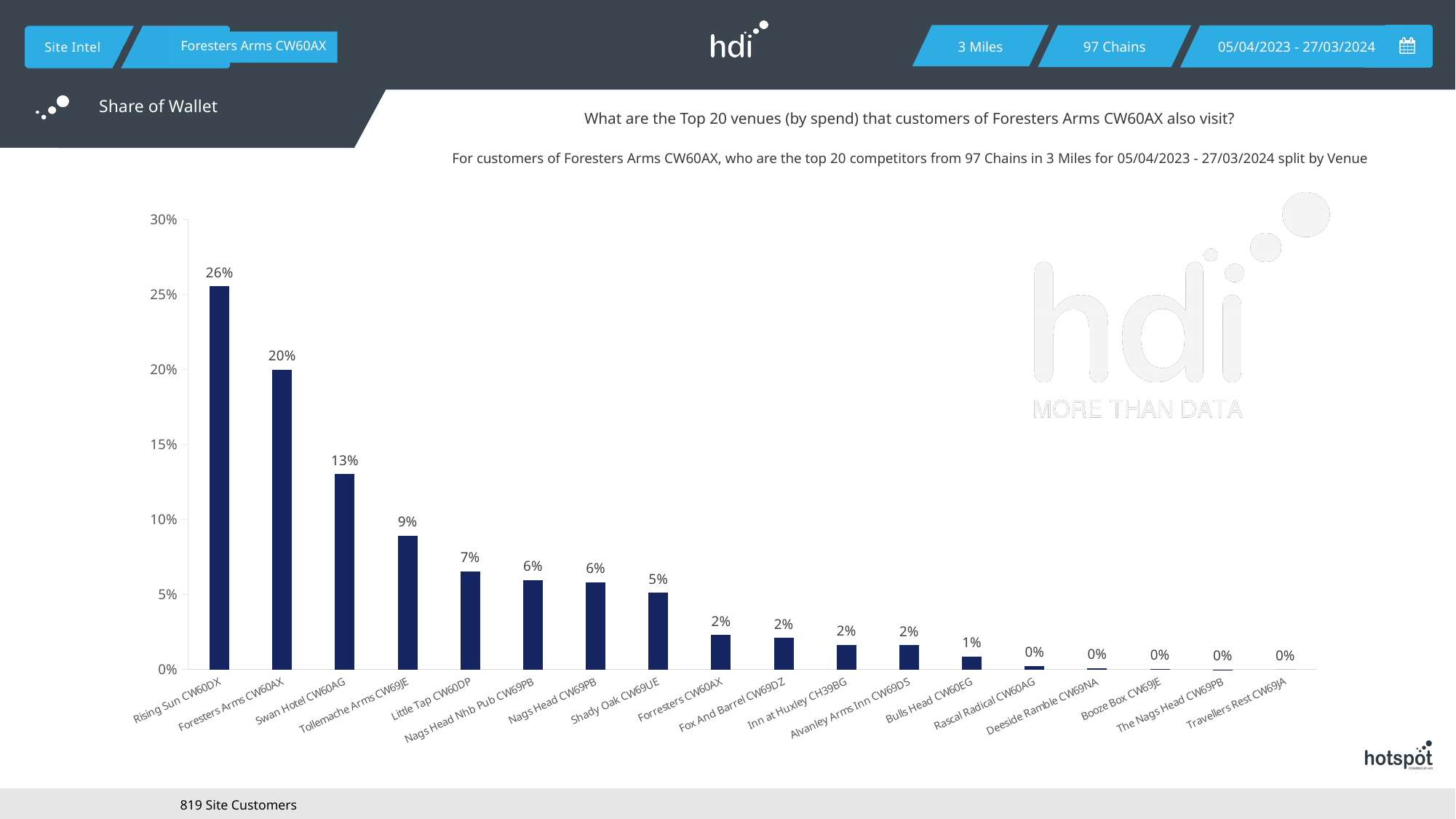
What is the value for Shady Oak CW69UE? 5% Which is larger, the value for Little Tap CW60DP or the value for Shady Oak CW69UE? Little Tap CW60DP What is the difference between the values for Rising Sun CW60DX and Foresters Arms CW60AX? 6% Which venue has the highest value? Rising Sun CW60DX What kind of chart is shown on the slide? Bar chart What is the value for Swan Hotel CW60AG? 13% How many venues are shown on the chart? 18 What is the value for Bulls Head CW60EG? 1% What is the value for Rising Sun CW60DX? 26% What is the value for Tollemache Arms CW69JE? 9% What is the difference between the values for Swan Hotel CW60AG and Little Tap CW60DP? 6% Do the values rise or fall from left to right along the x axis? Fall